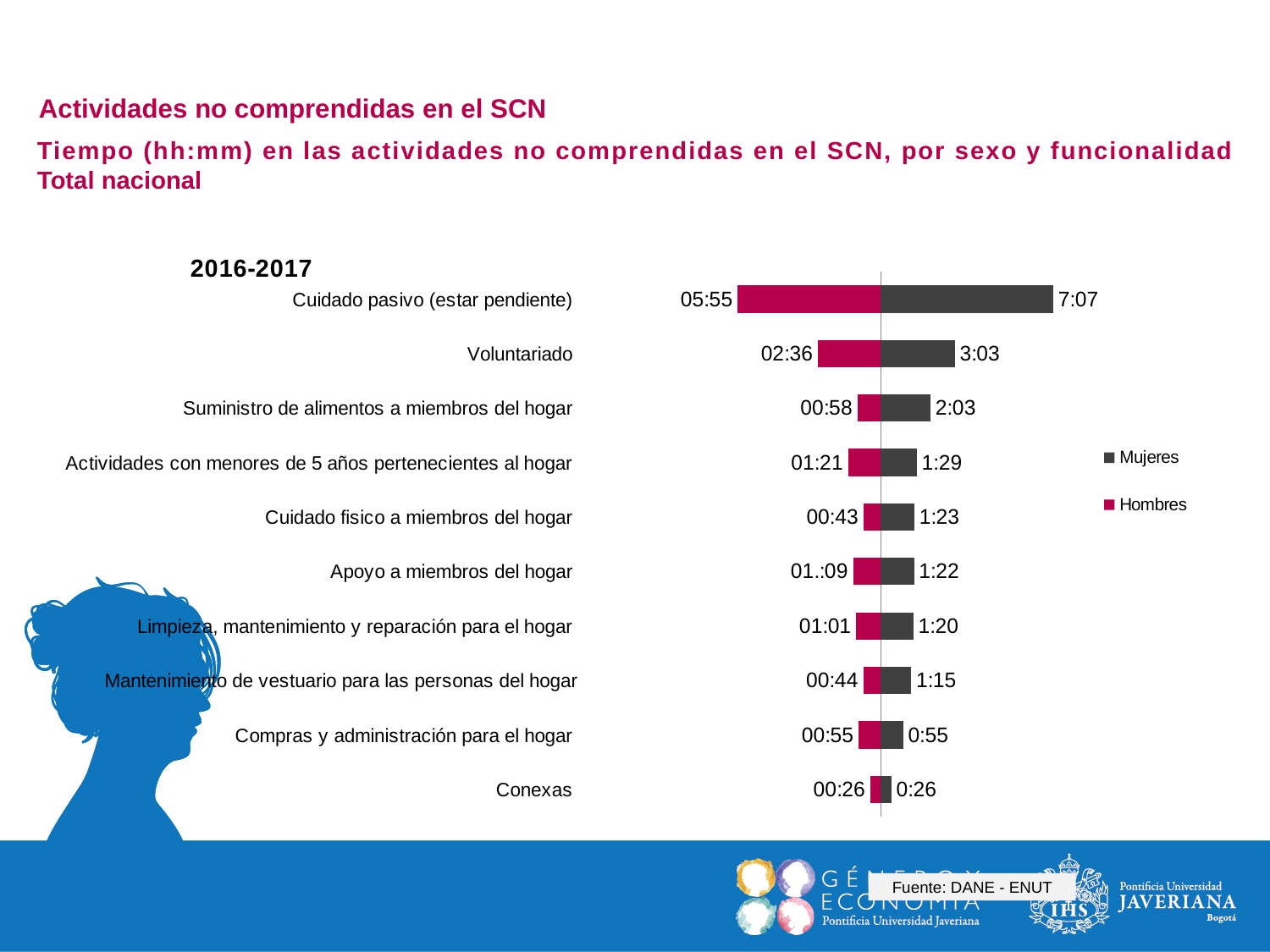
What is the value for Hombres for Voluntariado? 02:36 What is the value for Mujeres for Suministro de alimentos a miembros del hogar? 2:03 For Voluntariado, which series has the larger value, Mujeres or Hombres? Mujeres Which colour represents Hombres in the chart? Magenta (pink-red) What is the value for Hombres for Cuidado fisico a miembros del hogar? 00:43 Which activity has the highest value for Mujeres? Cuidado pasivo (estar pendiente) What is the difference between the Mujeres and Hombres values for Cuidado pasivo (estar pendiente)? 1:12 What is the value for Mujeres for Cuidado pasivo (estar pendiente)? 7:07 How many series does the legend list? 2 How many activities are shown in the chart? 10 What kind of chart is shown on the slide? Bar chart Which activity has the lowest value for Hombres? Conexas